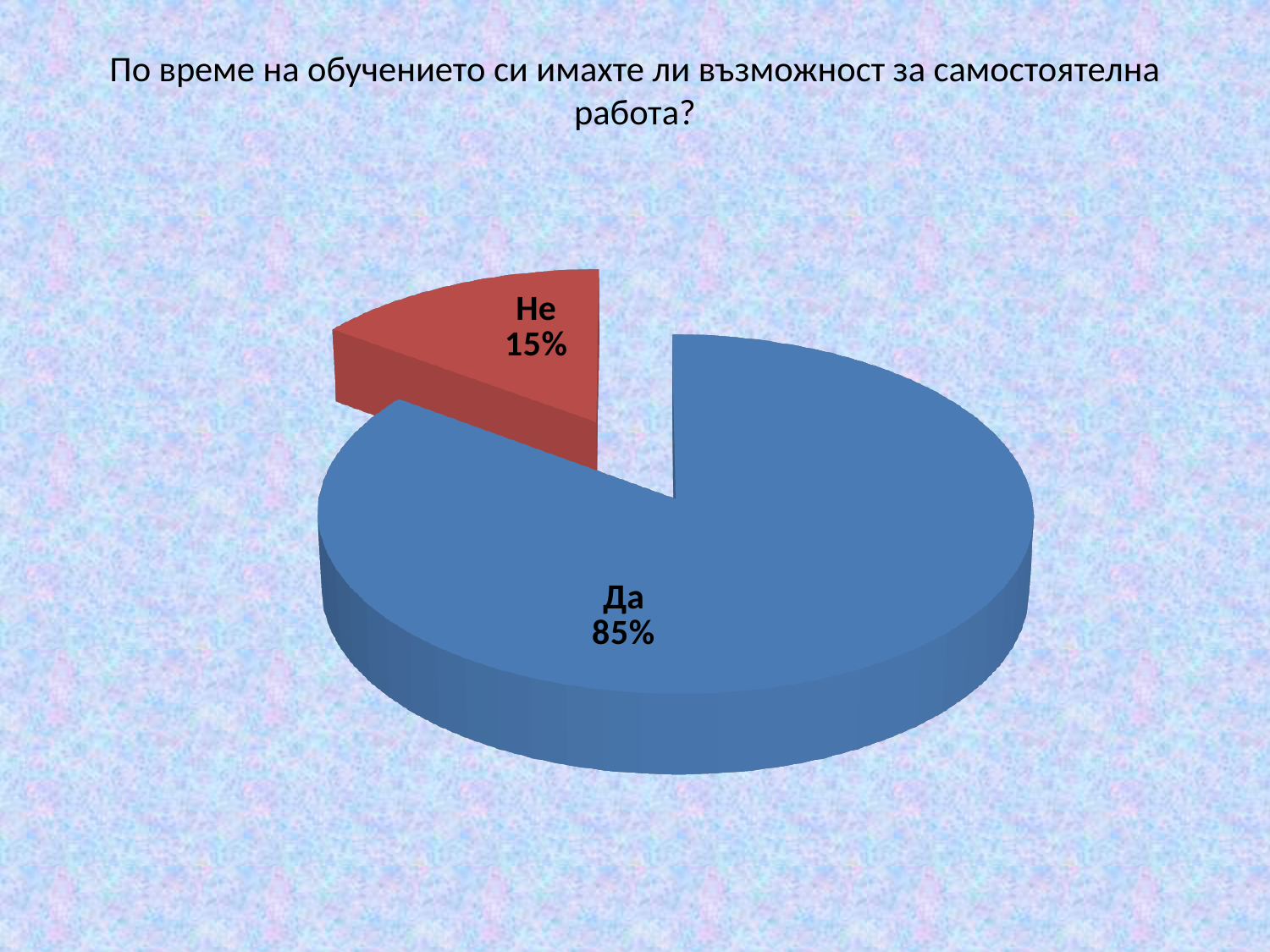
What percentage is shown for the "Да" slice? 85% Which is larger, the "Да" slice or the "Не" slice? Да What is the difference in percentage points between the "Да" and "Не" slices? 70 What share of the pie does the "Не" slice represent? 15% What percentage is shown for the "Не" slice? 15% What kind of chart is shown on the slide? pie chart How many slices does the pie chart have? 2 Which slice is the smallest? Не What colour is the "Да" slice? blue Which slice is the largest? Да What colour is the "Не" slice? red